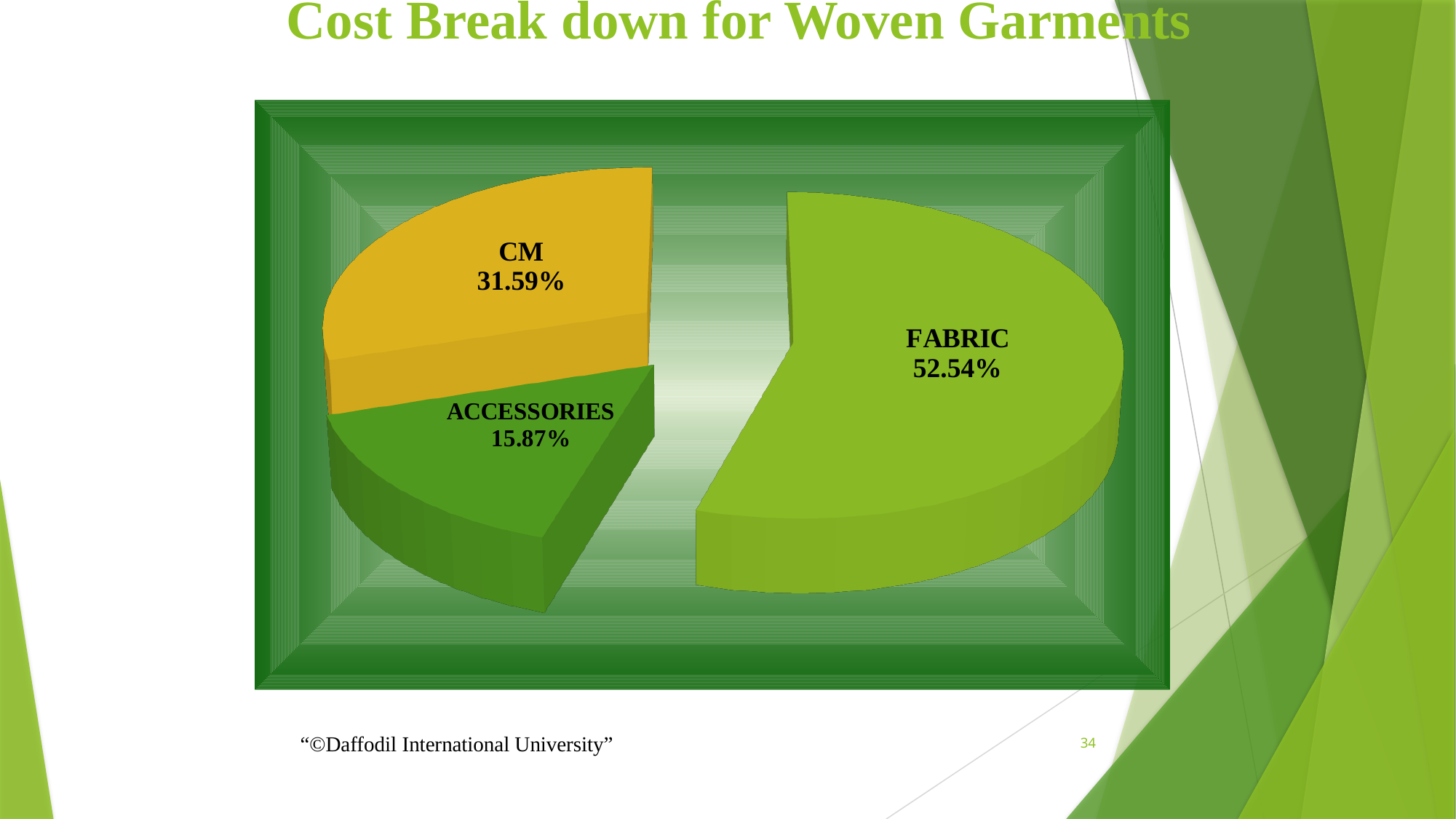
What share of the cost is ACCESSORIES? 15.87% What share of the cost is FABRIC? 52.54% What share of the cost is CM? 31.59% How many categories are shown in the pie chart? 3 Which category has the smallest share of the cost? ACCESSORIES What is the difference between the FABRIC share and the CM share? 20.95% What colour is the CM slice? Yellow What kind of chart is shown on the slide? Pie chart Which is larger, the share for CM or the share for ACCESSORIES? CM What is the title of the chart? Cost Break down for Woven Garments What is the difference between the CM share and the ACCESSORIES share? 15.72% Which category has the largest share of the cost? FABRIC